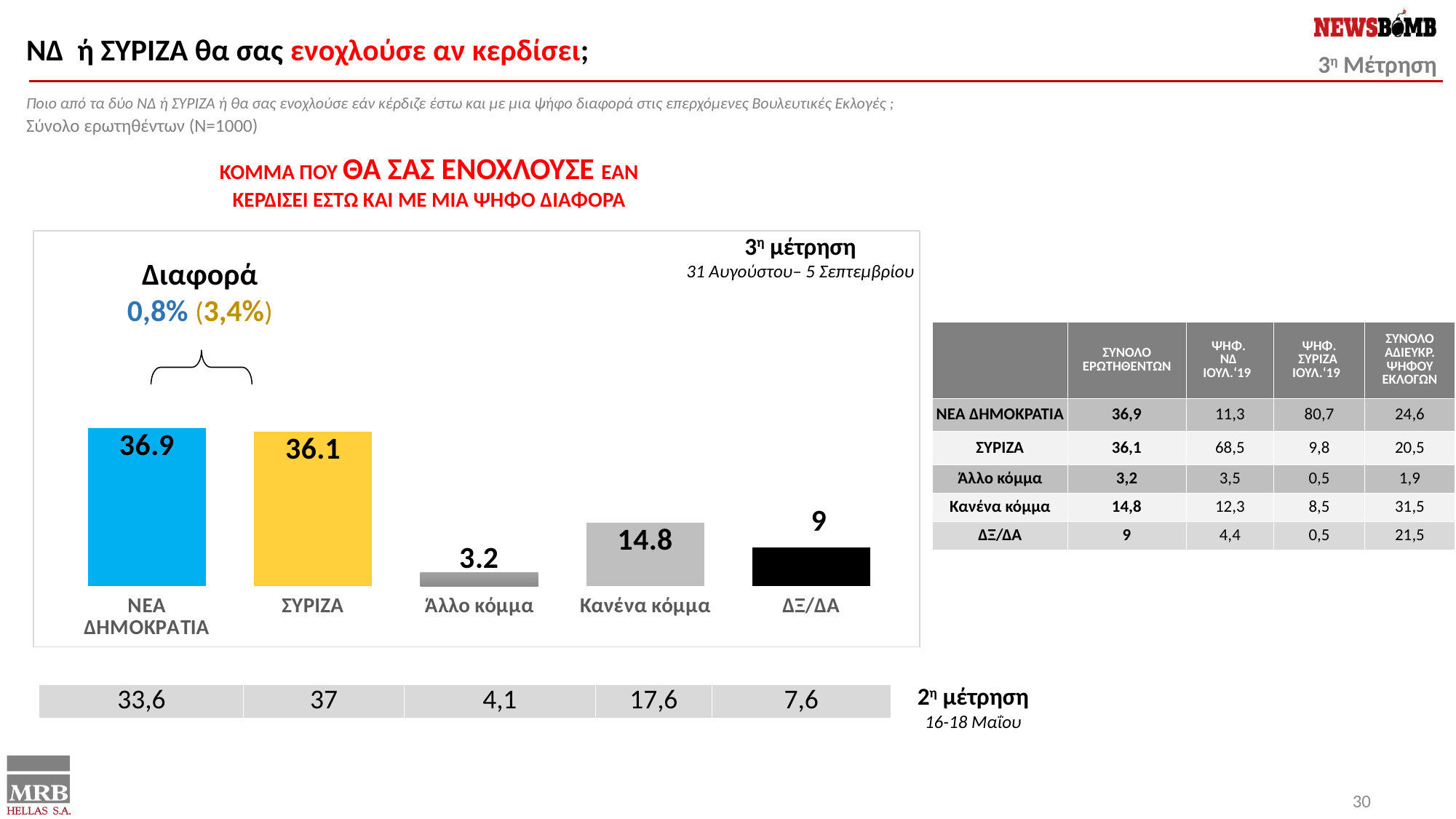
Which is larger in the bar chart, the value for Κανένα κόμμα or the value for ΔΞ/ΔΑ? Κανένα κόμμα What kind of chart is shown on the slide? bar chart What value is shown for ΔΞ/ΔΑ in the bar chart? 9 Which category has the lowest value in the bar chart? Άλλο κόμμα What is the difference between the values for ΝΕΑ ΔΗΜΟΚΡΑΤΙΑ and ΣΥΡΙΖΑ in the bar chart? 0.8 What value is shown for Κανένα κόμμα in the bar chart? 14.8 Which category has the highest value in the bar chart? ΝΕΑ ΔΗΜΟΚΡΑΤΙΑ What is the difference between the values for Κανένα κόμμα and ΔΞ/ΔΑ in the bar chart? 5.8 How many categories are shown in the bar chart? 5 What value is shown for ΝΕΑ ΔΗΜΟΚΡΑΤΙΑ in the bar chart? 36.9 What colour is the bar for ΝΕΑ ΔΗΜΟΚΡΑΤΙΑ in the bar chart? blue What value is shown for ΣΥΡΙΖΑ in the bar chart? 36.1